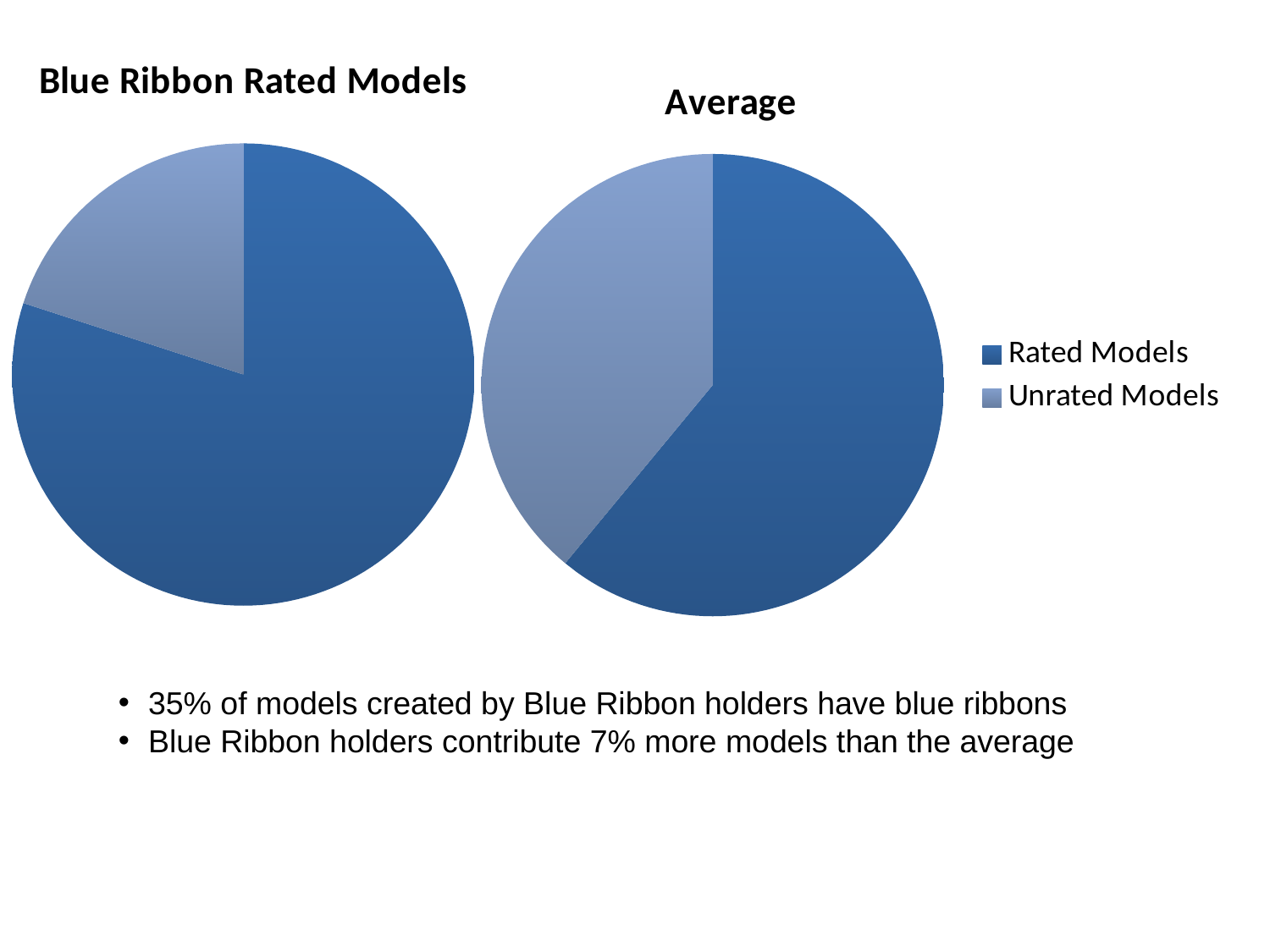
In the "Blue Ribbon Rated Models" chart, which slice is the smallest? Unrated Models In the "Average" chart, which slice is the smallest? Unrated Models In the "Blue Ribbon Rated Models" chart, which slice is the largest? Rated Models Which legend entry is shown in the lighter blue colour? Unrated Models In the "Average" chart, which slice is the largest? Rated Models How many entries does the legend list? 2 What kind of chart is the "Average" chart? pie chart What is the title of the pie chart on the left? Blue Ribbon Rated Models How many slices does the "Blue Ribbon Rated Models" pie chart have? 2 How many slices does the "Average" pie chart have? 2 Which chart has the larger Unrated Models slice, "Blue Ribbon Rated Models" or "Average"? Average What kind of chart is the "Blue Ribbon Rated Models" chart? pie chart